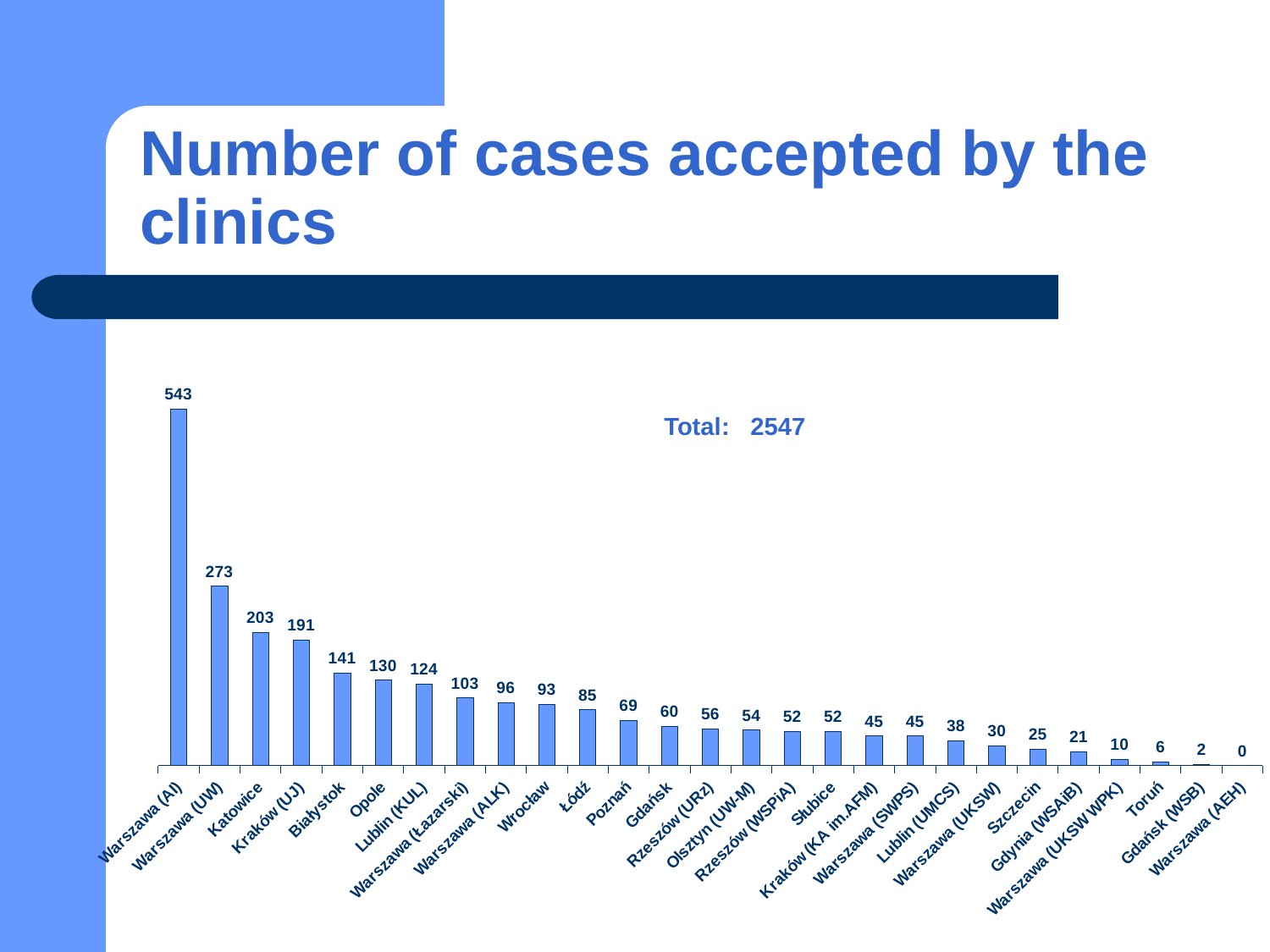
What is the number of cases accepted by the Białystok clinic? 141 Which clinic accepted the lowest number of cases? Warszawa (AEH) How many cases were accepted by the Warszawa (AI) clinic? 543 What type of chart is shown on the slide? Bar chart What is the difference between the number of cases accepted by Warszawa (AI) and Warszawa (UW)? 270 Which clinic accepted more cases, Poznań or Gdańsk? Poznań How many cases did the Olsztyn (UW-M) clinic accept? 54 Which clinic accepted the highest number of cases? Warszawa (AI) How many clinics are shown on the chart? 27 What total number of cases is printed on the chart? 2547 Do the values rise or fall from left to right along the x axis? Fall How many more cases did Katowice accept than Kraków (UJ)? 12